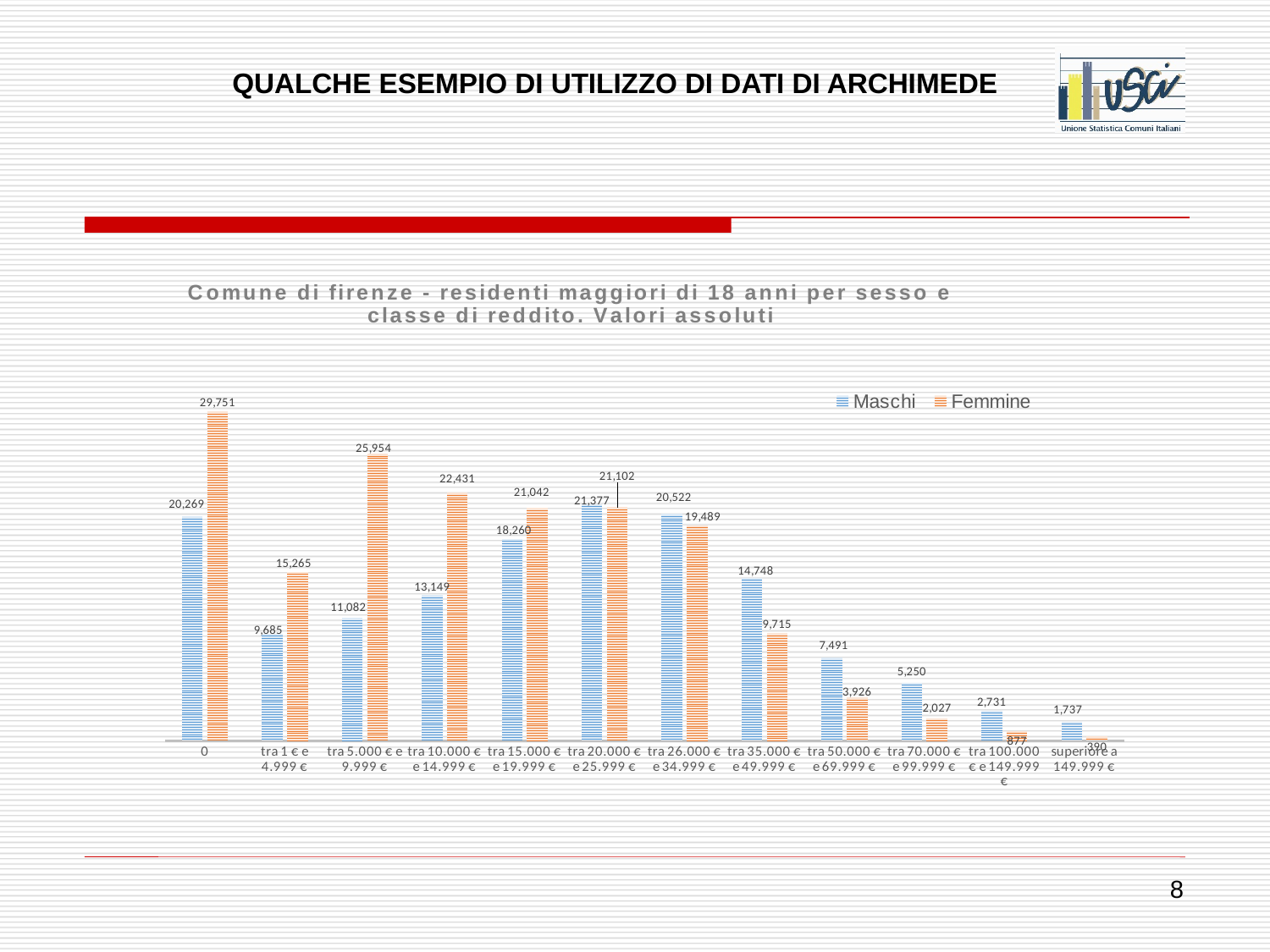
Which income class has the lowest value for Maschi? superiore a 149.999 € What is the difference between Femmine and Maschi in the class 'tra 5.000 € e 9.999 €'? 14,872 What is the value for Femmine in the income class 0? 29,751 How many series does the legend list? 2 In the class 'tra 35.000 € e 49.999 €', which series has the larger value, Maschi or Femmine? Maschi Which income class has the highest value for Femmine? 0 Which series is shown in orange in the legend? Femmine How many income classes (categories) are shown on the x axis? 12 What is the value for Maschi in the class 'tra 5.000 € e 9.999 €'? 11,082 What type of chart is shown on the slide? Bar chart Do the Femmine values rise or fall along the x axis from the class 'tra 10.000 € e 14.999 €' to 'superiore a 149.999 €'? Fall What is the value for Femmine in the class 'superiore a 149.999 €'? 390